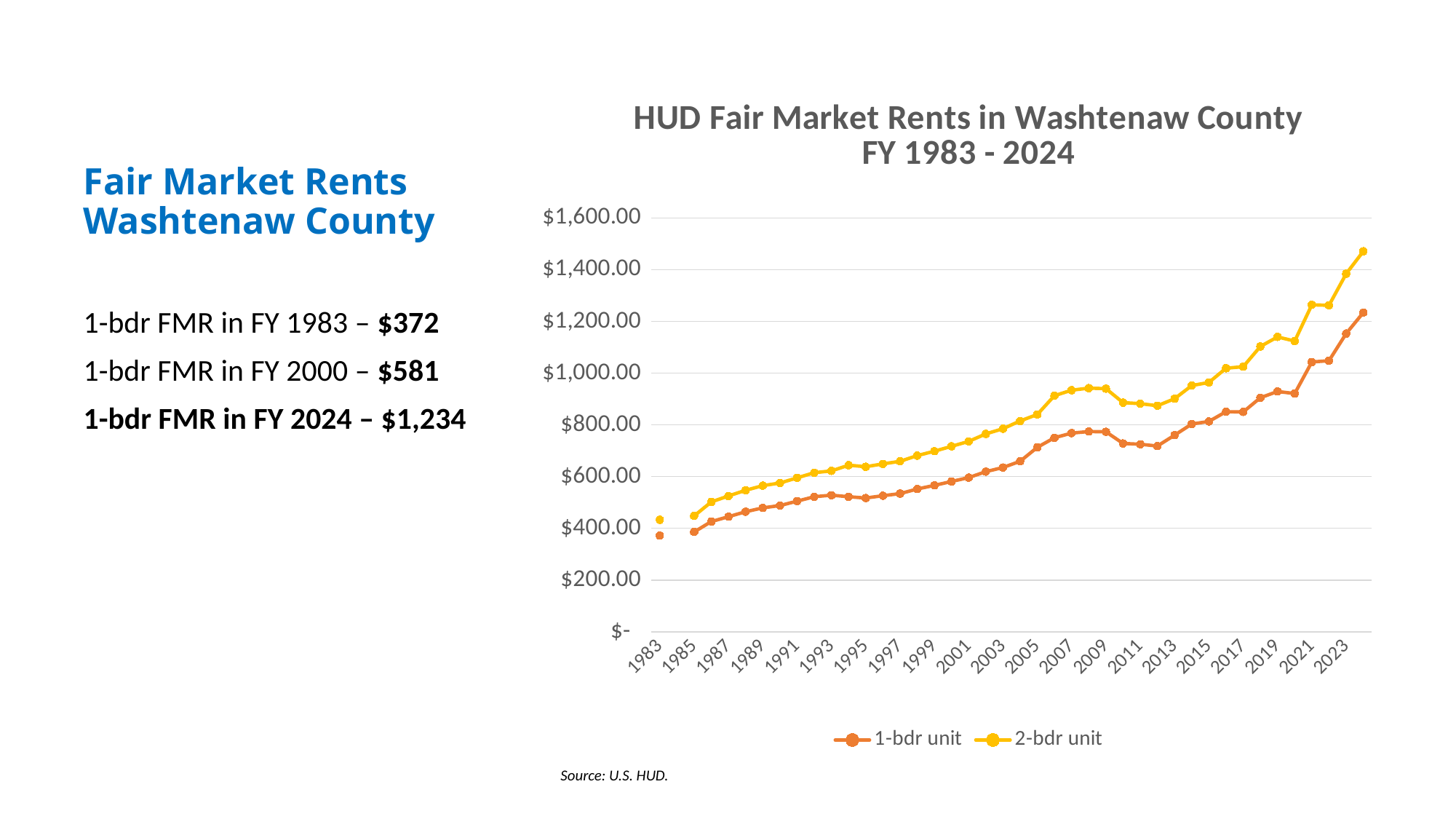
What kind of chart is shown on the slide? line chart How many series does the chart's legend list? 2 What was the 1-bdr FMR in FY 1983? $372 Overall, do the fair market rents rise or fall from 1983 to 2024? rise What was the 1-bdr FMR in FY 2024? $1,234 What are the two series named in the chart legend? 1-bdr unit and 2-bdr unit Which series has the higher value in 2024, 1-bdr unit or 2-bdr unit? 2-bdr unit What is the title of the chart? HUD Fair Market Rents in Washtenaw County FY 1983 - 2024 Is the value for the 2-bdr unit in 2023 greater or less than $1,200.00? greater What was the 1-bdr FMR in FY 2000? $581 By how much did the 1-bdr FMR increase from FY 1983 to FY 2000? $209 By how much did the 1-bdr FMR increase from FY 1983 to FY 2024? $862